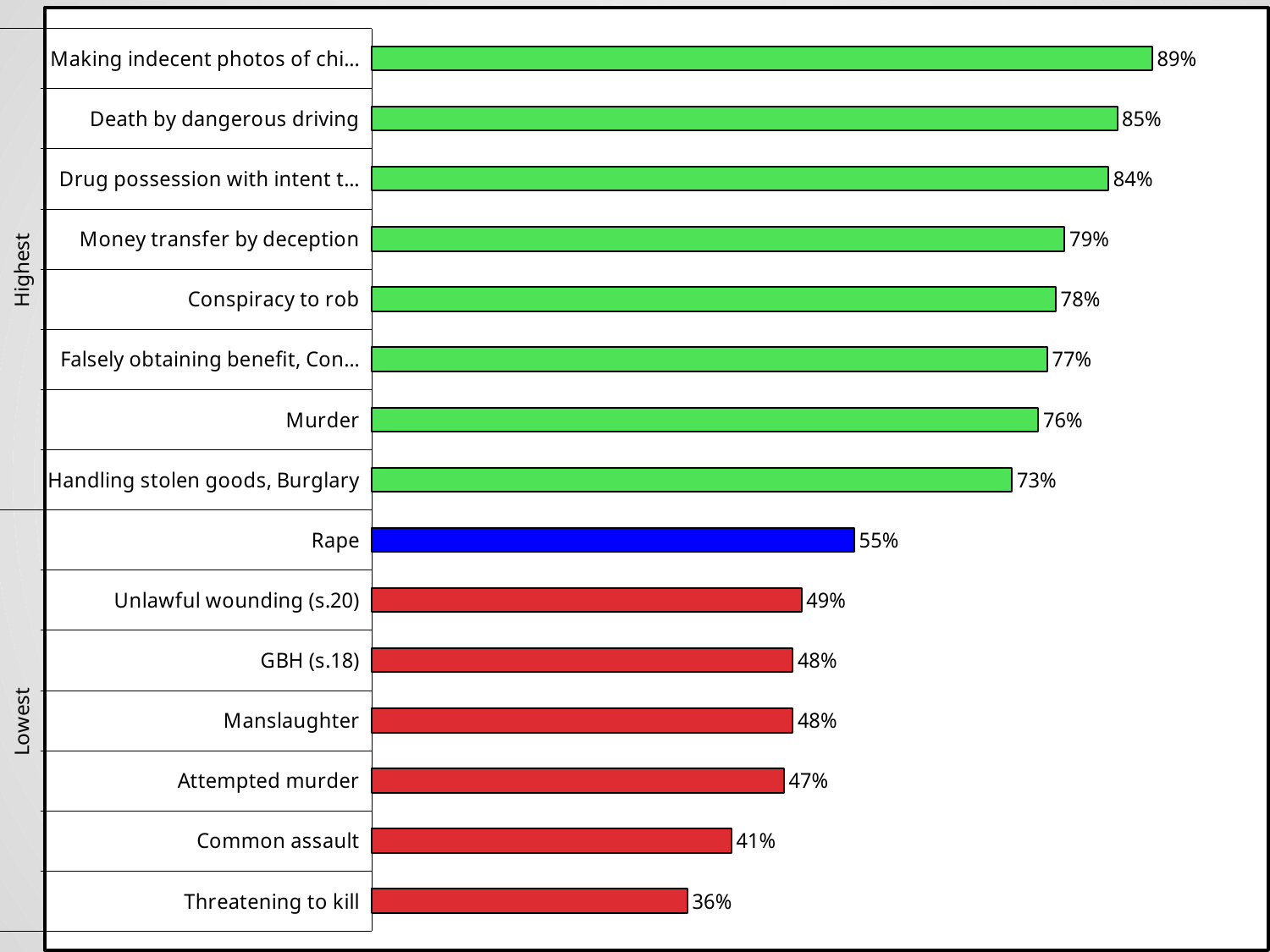
What are the two group labels shown on the left side of the chart? Highest and Lowest How many categories are shown in the chart? 15 Which is larger, the value for Money transfer by deception or the value for Handling stolen goods, Burglary? Money transfer by deception What is the value for Murder? 76% What is the value for Common assault? 41% What is the value for Rape? 55% What is the value for Death by dangerous driving? 85% Which category has the lowest value? Threatening to kill What kind of chart is this? Bar chart Which category has the highest value? Making indecent photos of chi... What colour is the bar for Rape? Blue What is the difference between the values for Conspiracy to rob and Attempted murder? 31%